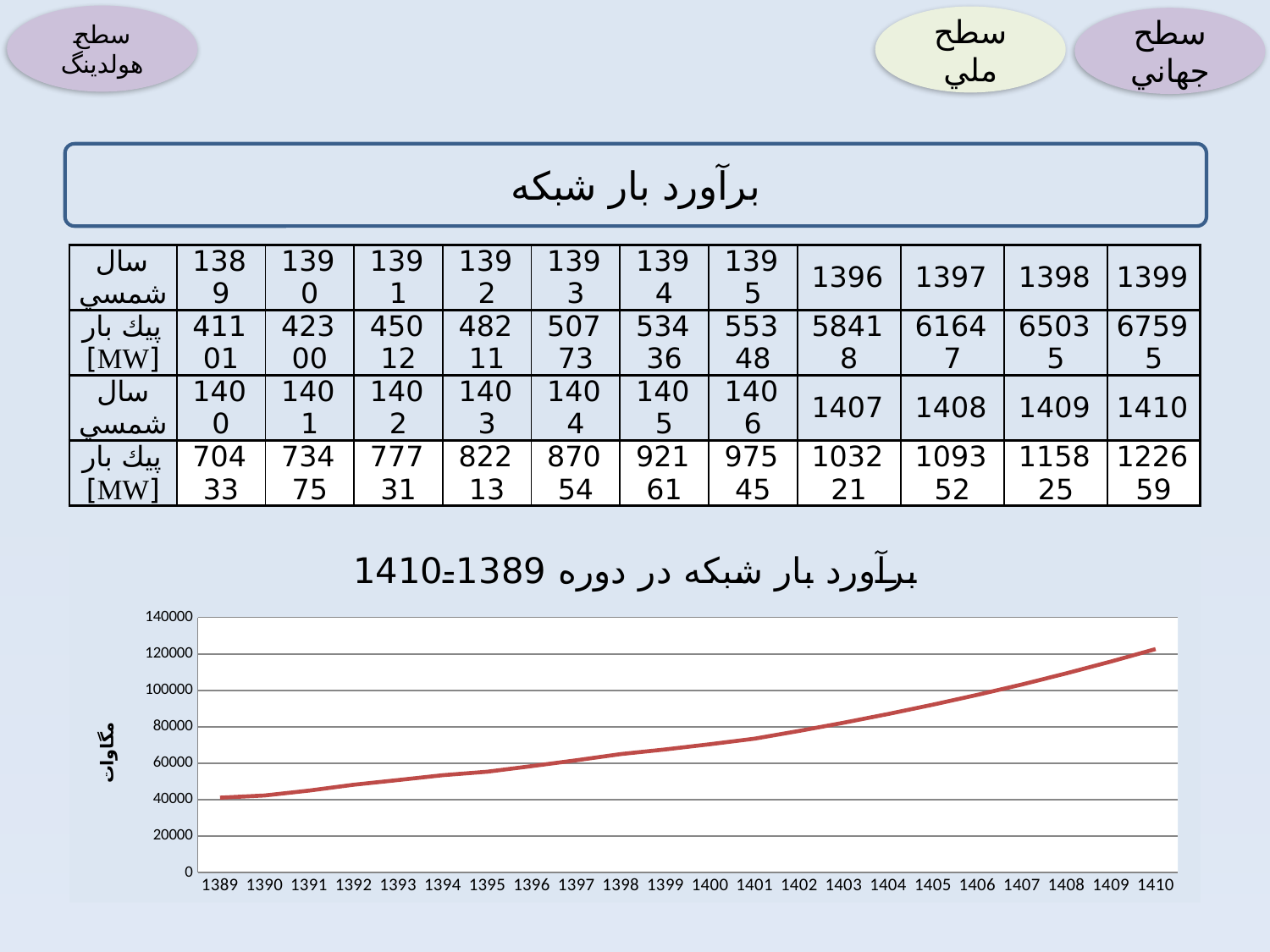
Which year has the highest value on the chart? 1410 Is the value for 1393 greater or less than 60000? less What is the title of the chart? برآورد بار شبکه در دوره 1389-1410 What is the label on the vertical axis of the chart? مگاوات Is the value for 1405 greater or less than 100000? less Is the value for 1404 greater or less than 80000? greater Does the plotted line rise or fall from 1389 to 1410? rises Which year has the lowest value on the chart? 1389 How many years are plotted along the x axis of the chart? 22 Which year has the larger value on the chart, 1398 or 1406? 1406 What kind of chart is shown at the bottom of the slide? line chart